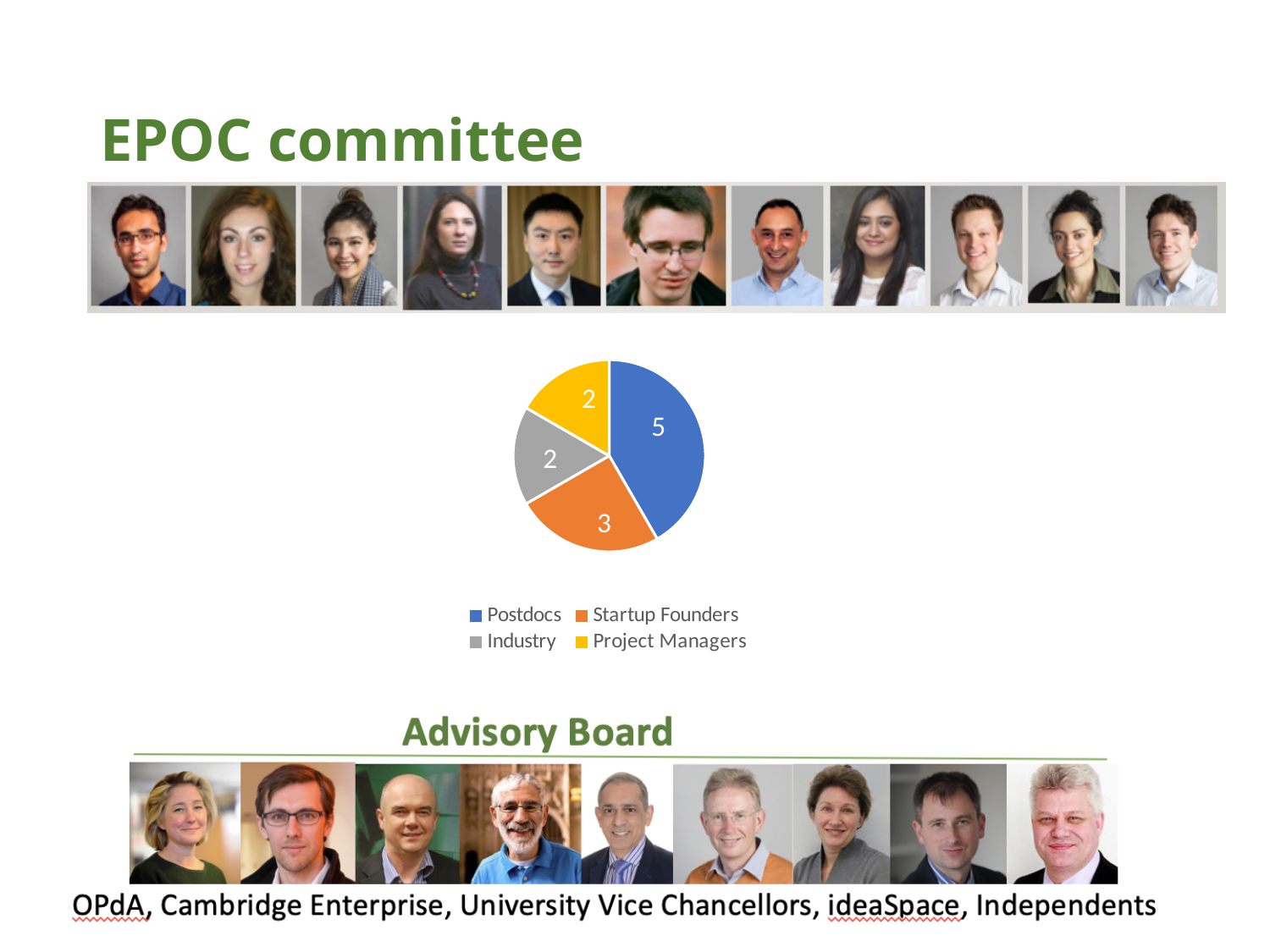
Which category has the largest slice in the pie chart? Postdocs What type of chart is shown on the slide? pie chart What is the total of all the slices in the pie chart? 12 How many Postdocs are on the EPOC committee according to the pie chart? 5 Which category is shown in yellow in the pie chart legend? Project Managers Which is larger in the pie chart, Startup Founders or Industry? Startup Founders What is the value for Industry in the pie chart? 2 What colour is the Postdocs slice in the pie chart? blue How many categories does the pie chart show? 4 What is the value for Startup Founders in the pie chart? 3 What is the difference between the Postdocs value and the Startup Founders value? 2 What is the value for Project Managers in the pie chart? 2